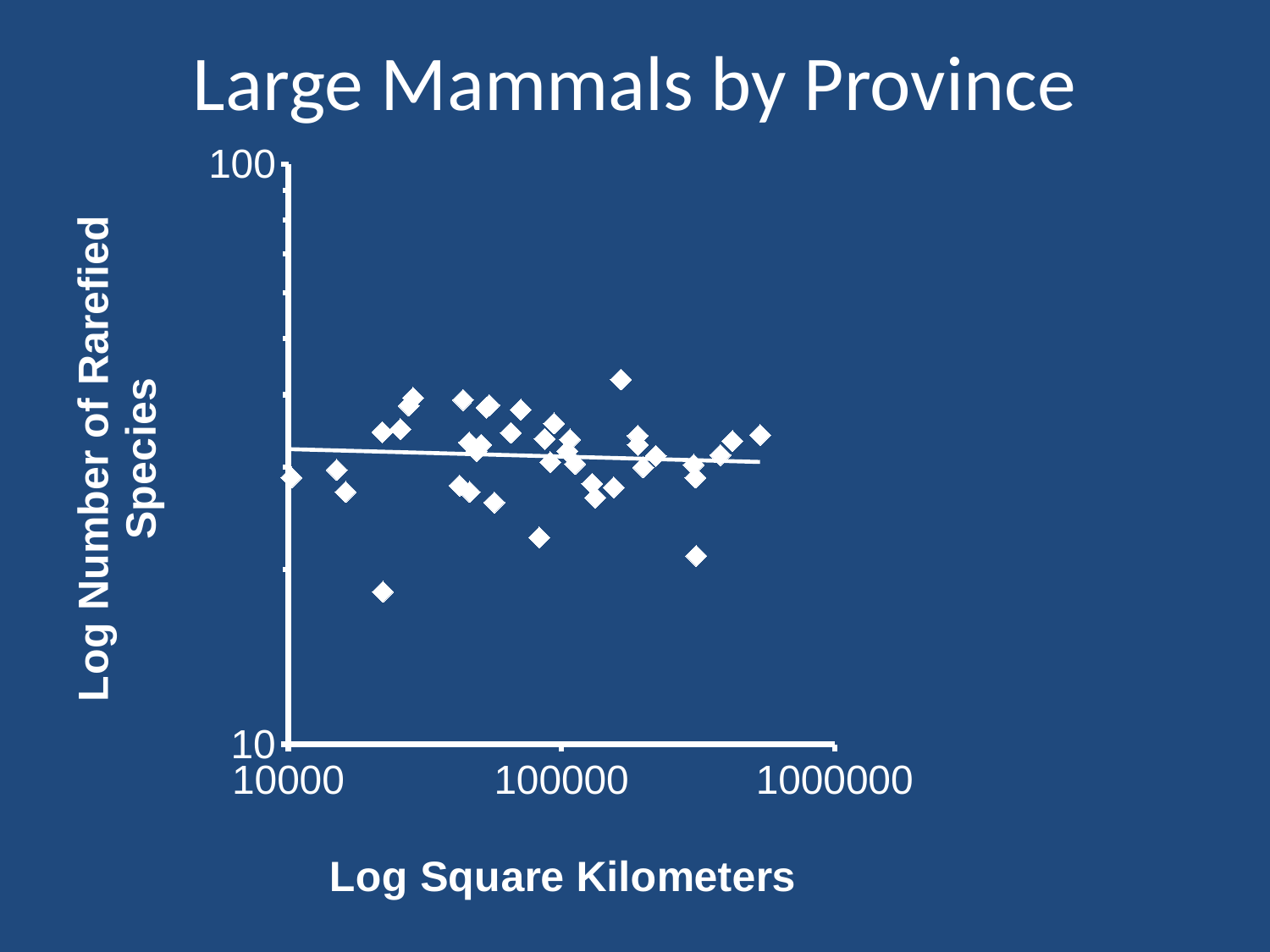
Are all of the plotted points below 100 on the y axis? yes Is the highest plotted point greater or less than 50 on the y axis? less Is the lowest plotted point greater or less than 10 on the y axis? greater What is the title of the chart? Large Mammals by Province What is the label on the y axis of the chart? Log Number of Rarefied Species What kind of chart is shown on the slide? scatter chart According to the fitted line, does the number of rarefied species rise steeply, fall steeply, or stay roughly flat as square kilometers increase? roughly flat